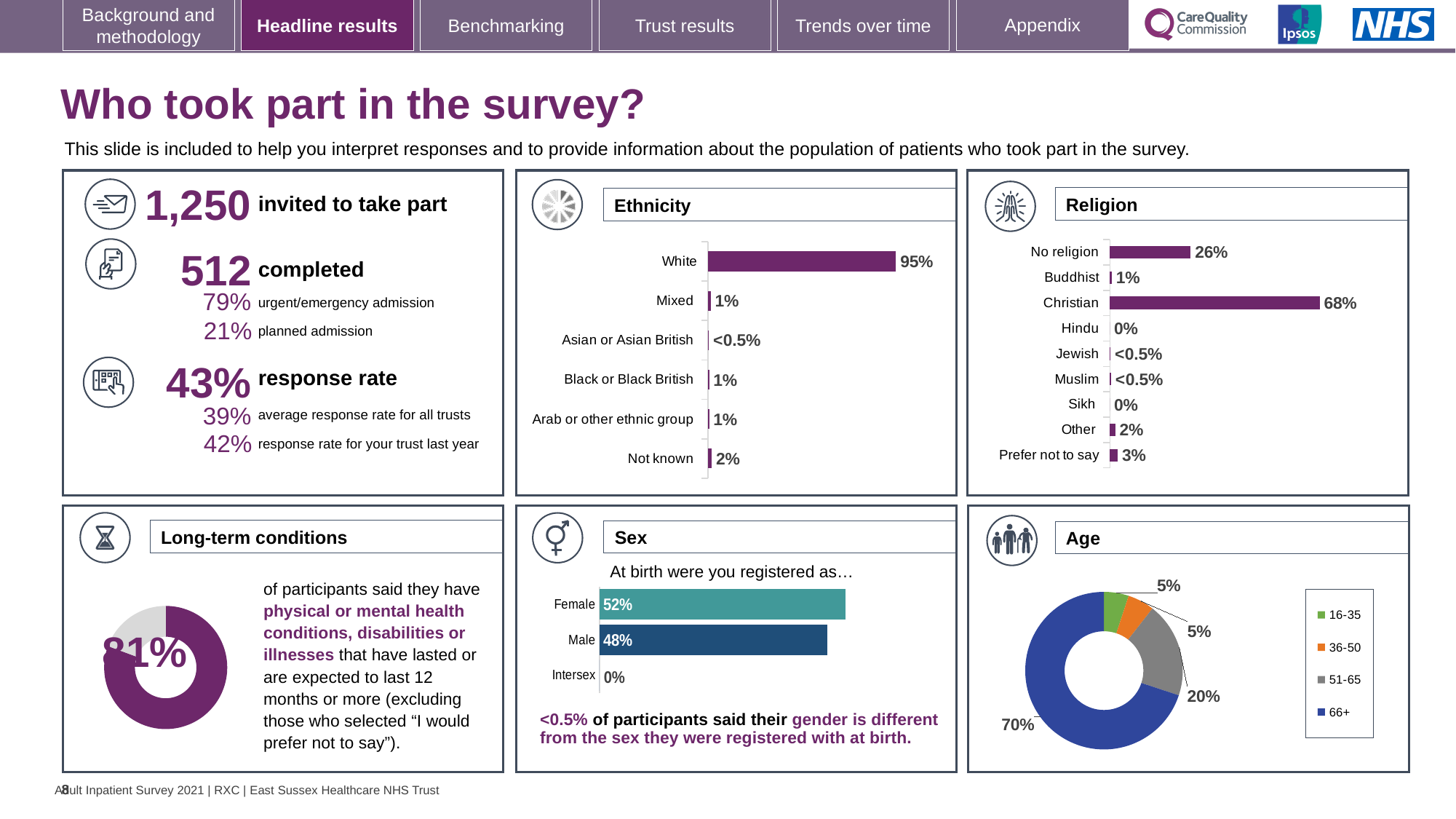
In the Sex chart, which is larger, Female or Male? Female In the Ethnicity chart, what percentage of participants were White? 95% In the Long-term conditions chart, what percentage of participants said they have long-term conditions? 81% How many categories are shown in the Religion chart? 9 How many age groups does the legend of the Age chart list? 4 In the Sex chart, what is the difference between the Female and Male values? 4% How many categories are shown in the Ethnicity chart? 6 In the Ethnicity chart, which category has the highest value? White In the Age chart, what share of participants were aged 66+? 70% In the Religion chart, what is the difference between the Christian and No religion values? 42% In the Religion chart, what percentage of participants were Christian? 68% What kind of chart is the Age chart? Donut chart